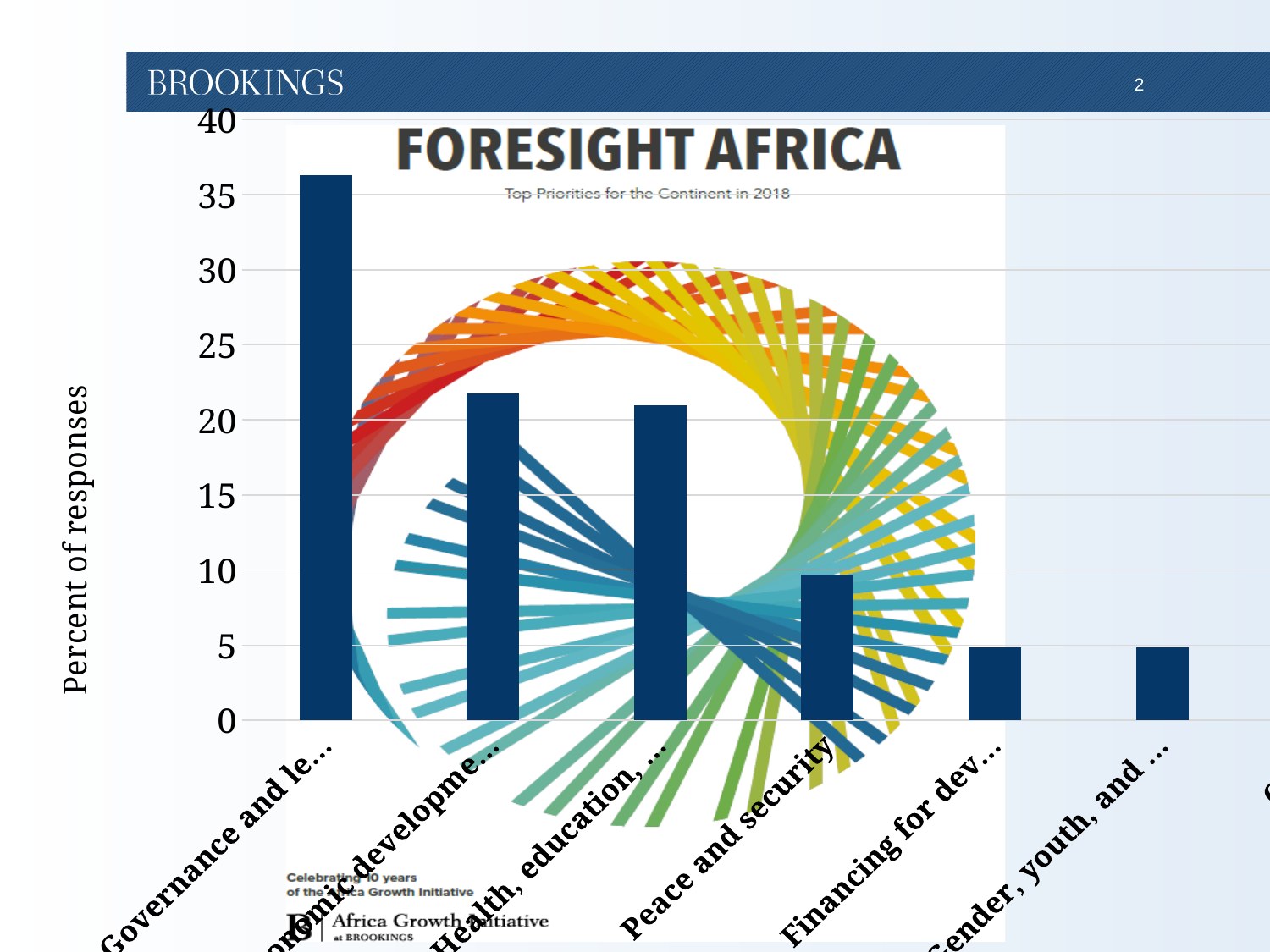
Is the value for the second bar (...omic developme...) greater or less than 20? greater What is the highest value shown on the vertical axis? 40 What kind of chart is shown on the slide? bar chart Is the value for Peace and security greater or less than 15? less Which category has the highest percent of responses? Governance and le... Is the value for Governance and le... greater or less than 30? greater What is the title of the vertical axis of the chart? Percent of responses Which is larger, the value for Peace and security or the value for Financing for dev...? Peace and security Which is larger, the value for Governance and le... or the value for Peace and security? Governance and le... Do the bar values generally rise or fall from left to right along the x axis? fall